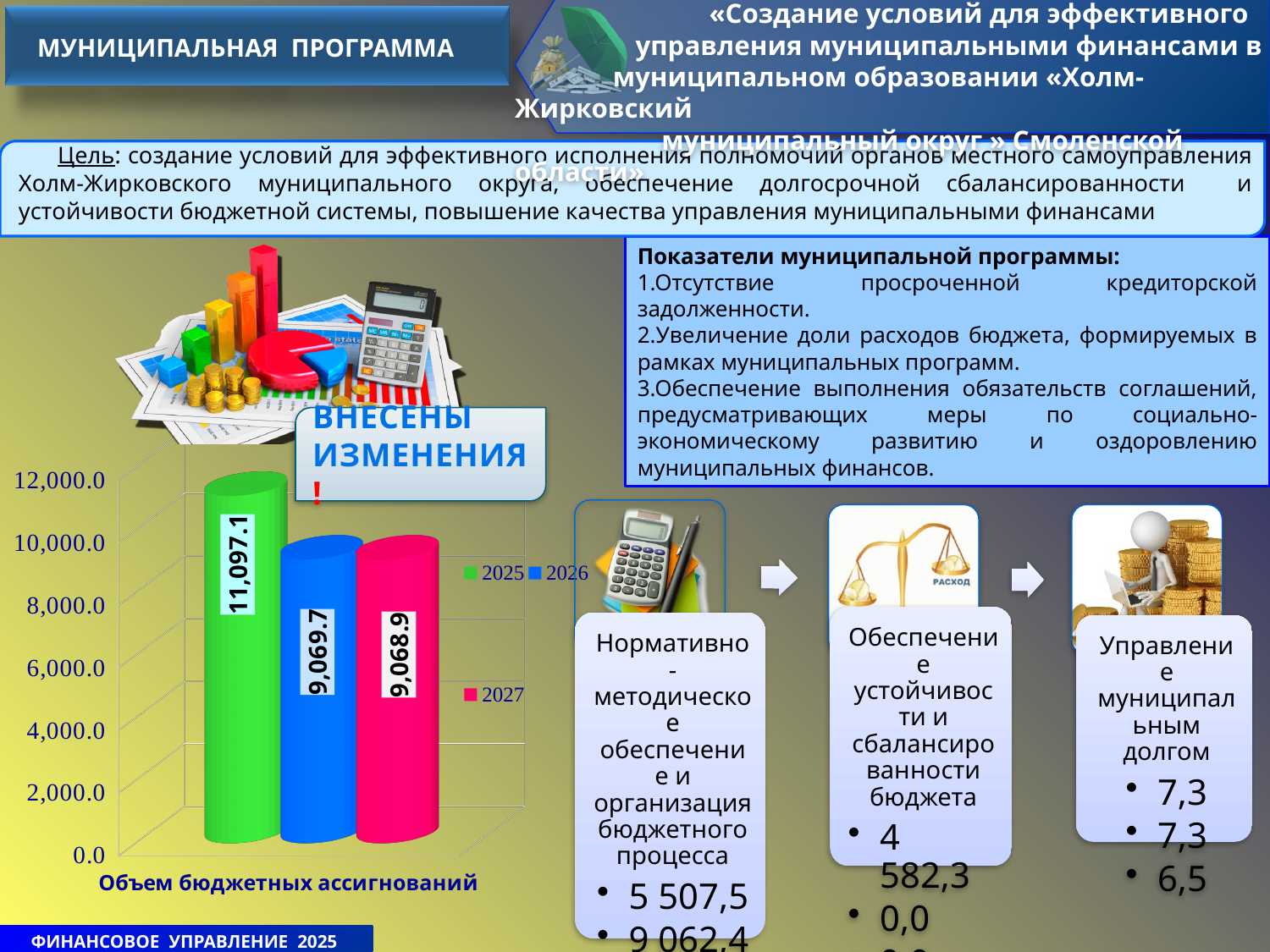
Which is larger in the chart 'Объем бюджетных ассигнований': the 2025 value or the 2027 value? 2025 What is the value of the 2027 bar in the chart 'Объем бюджетных ассигнований'? 9,068.9 What kind of chart is 'Объем бюджетных ассигнований'? bar chart How many series does the legend of the chart 'Объем бюджетных ассигнований' list? 3 What is the difference between the 2026 and 2027 values in the chart 'Объем бюджетных ассигнований'? 0.8 What is the value of the 2025 bar in the chart 'Объем бюджетных ассигнований'? 11,097.1 Which year has the highest value in the chart 'Объем бюджетных ассигнований'? 2025 What is the value of the 2026 bar in the chart 'Объем бюджетных ассигнований'? 9,069.7 Is the 2026 value in the chart 'Объем бюджетных ассигнований' greater or less than 10,000.0? less What is the difference between the 2025 and 2026 values in the chart 'Объем бюджетных ассигнований'? 2,027.4 Is the 2025 value in the chart 'Объем бюджетных ассигнований' greater or less than 10,000.0? greater What colour is the 2025 bar in the chart 'Объем бюджетных ассигнований'? green